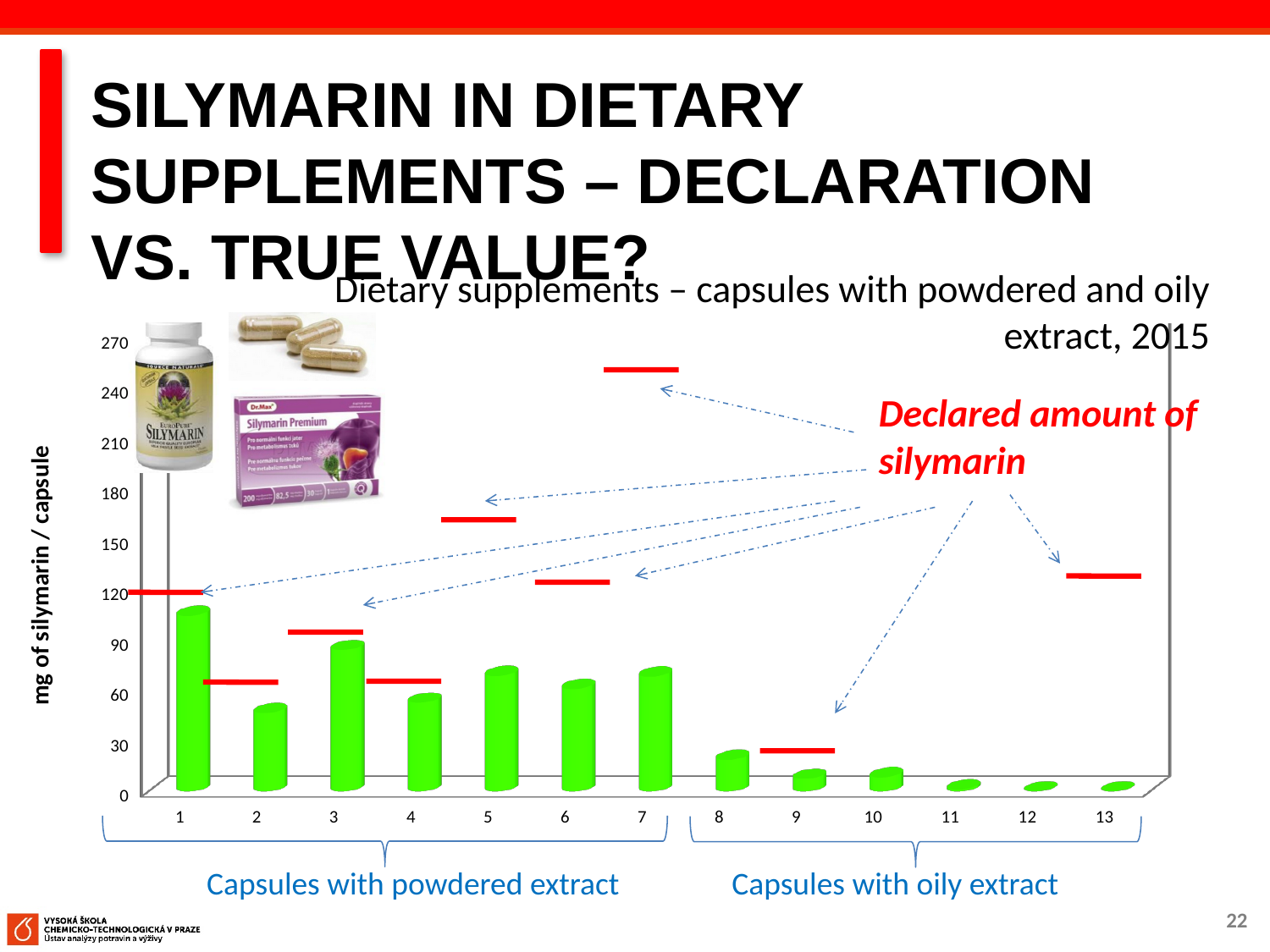
Do the measured values for samples 8 to 13 generally rise or fall along the x axis? fall Which sample has the highest measured silymarin content per capsule? 1 How many capsule samples (categories) are plotted on the x axis? 13 Which has a larger measured silymarin content, sample 1 or sample 2? sample 1 What kind of chart is shown on the slide? bar chart Is the measured value for sample 2 greater or less than 60 mg? less What do the red horizontal lines on the chart represent? Declared amount of silymarin Is the measured value for sample 1 greater or less than 90 mg? greater What is the label of the y axis? mg of silymarin / capsule Which has a larger measured silymarin content, sample 3 or sample 8? sample 3 Is the measured value for sample 8 greater or less than 30 mg? less